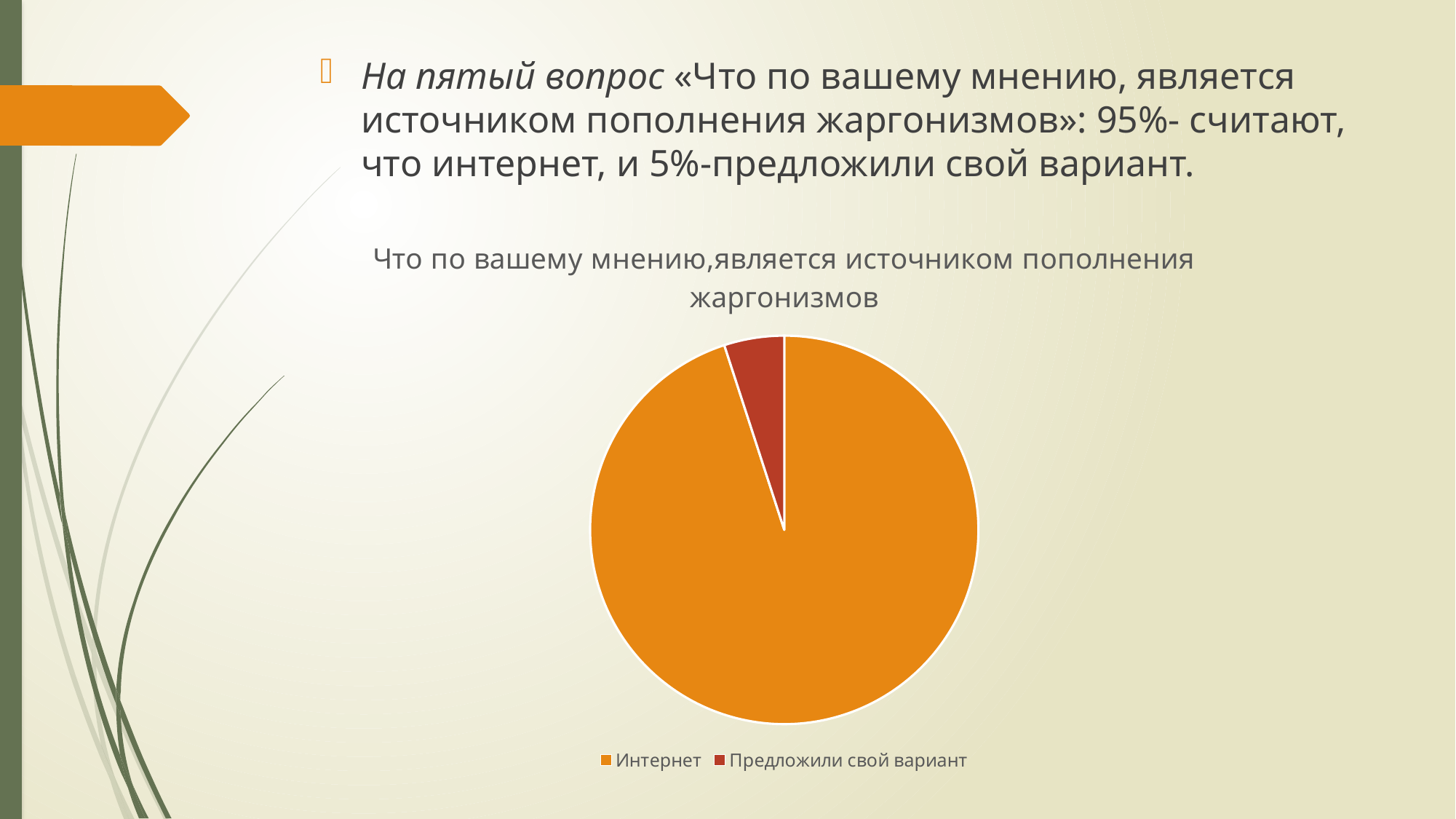
What is the title of the pie chart? Что по вашему мнению,является источником пополнения жаргонизмов What kind of chart is shown on the slide? pie chart How many entries does the legend of the pie chart list? 2 Which slice is larger in the pie chart: Интернет or Предложили свой вариант? Интернет What colour is the Интернет slice in the pie chart? orange Which category has the smallest slice in the pie chart? Предложили свой вариант Is the share for Интернет greater or less than 50%? greater Is the share for Предложили свой вариант greater or less than 25%? less What share of the pie does the Интернет slice represent, according to the slide? 95% How many slices does the pie chart have? 2 What share of the pie does the Предложили свой вариант slice represent, according to the slide? 5% Which category has the largest slice in the pie chart? Интернет